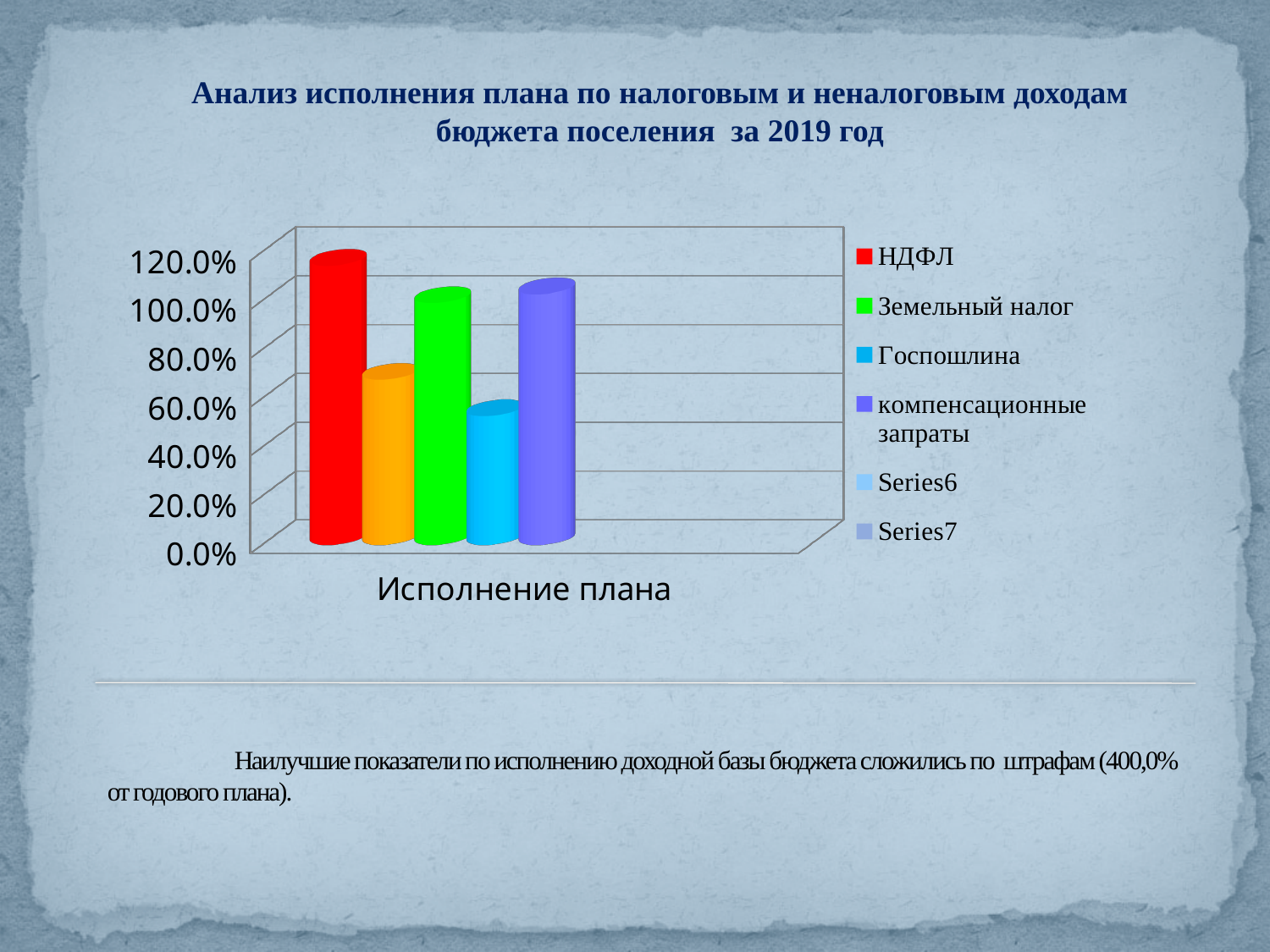
What is the category label shown on the x axis of the chart? Исполнение плана Is the value for Госпошлина greater or less than 80.0%? less Which series has the tallest bar in the chart? НДФЛ Which named series has the shortest bar in the chart? Госпошлина Is the value for НДФЛ greater or less than 100.0%? greater Is the value for компенсационные запраты greater or less than 80.0%? greater What kind of chart is shown on the slide? bar chart Which is larger, the value for НДФЛ or the value for Госпошлина? НДФЛ What colour is the bar for НДФЛ in the chart? red How many entries does the chart legend list? 6 How many bars are plotted in the chart? 5